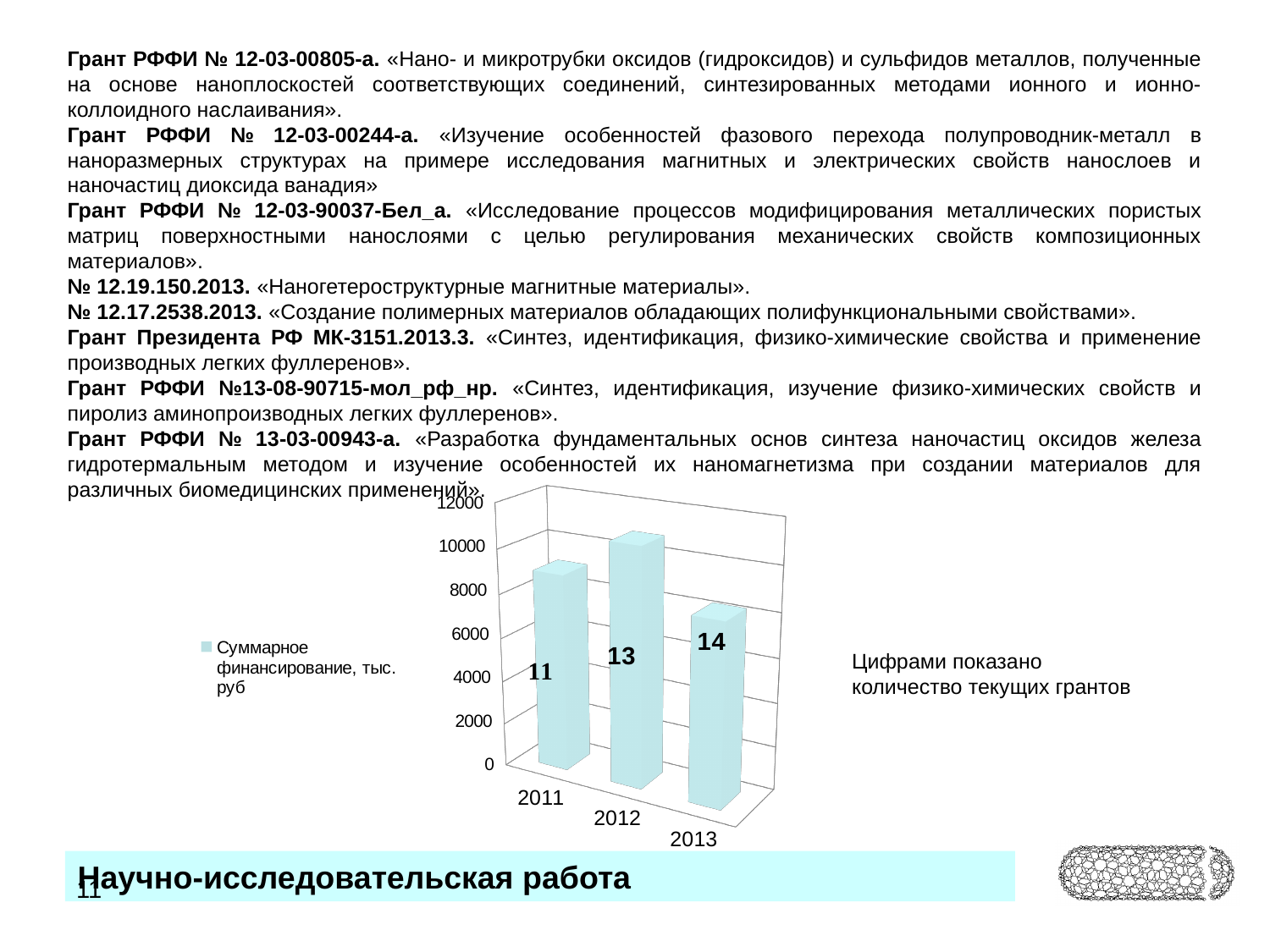
Which year has the highest bar on the chart? 2012 Does the value rise or fall from 2012 to 2013? fall How many series does the chart legend list? 1 Which year has the lowest bar on the chart? 2013 Which is larger, the value for 2011 or the value for 2013? 2011 Is the value for 2013 greater or less than 10000? less Is the value for 2012 greater or less than 8000? greater What kind of chart is shown on the slide? bar chart What is the legend entry of the chart? Суммарное финансирование, тыс. руб Is the value for 2011 greater or less than 6000? greater Which is larger, the value for 2012 or the value for 2011? 2012 How many years (categories) are shown on the chart's x axis? 3